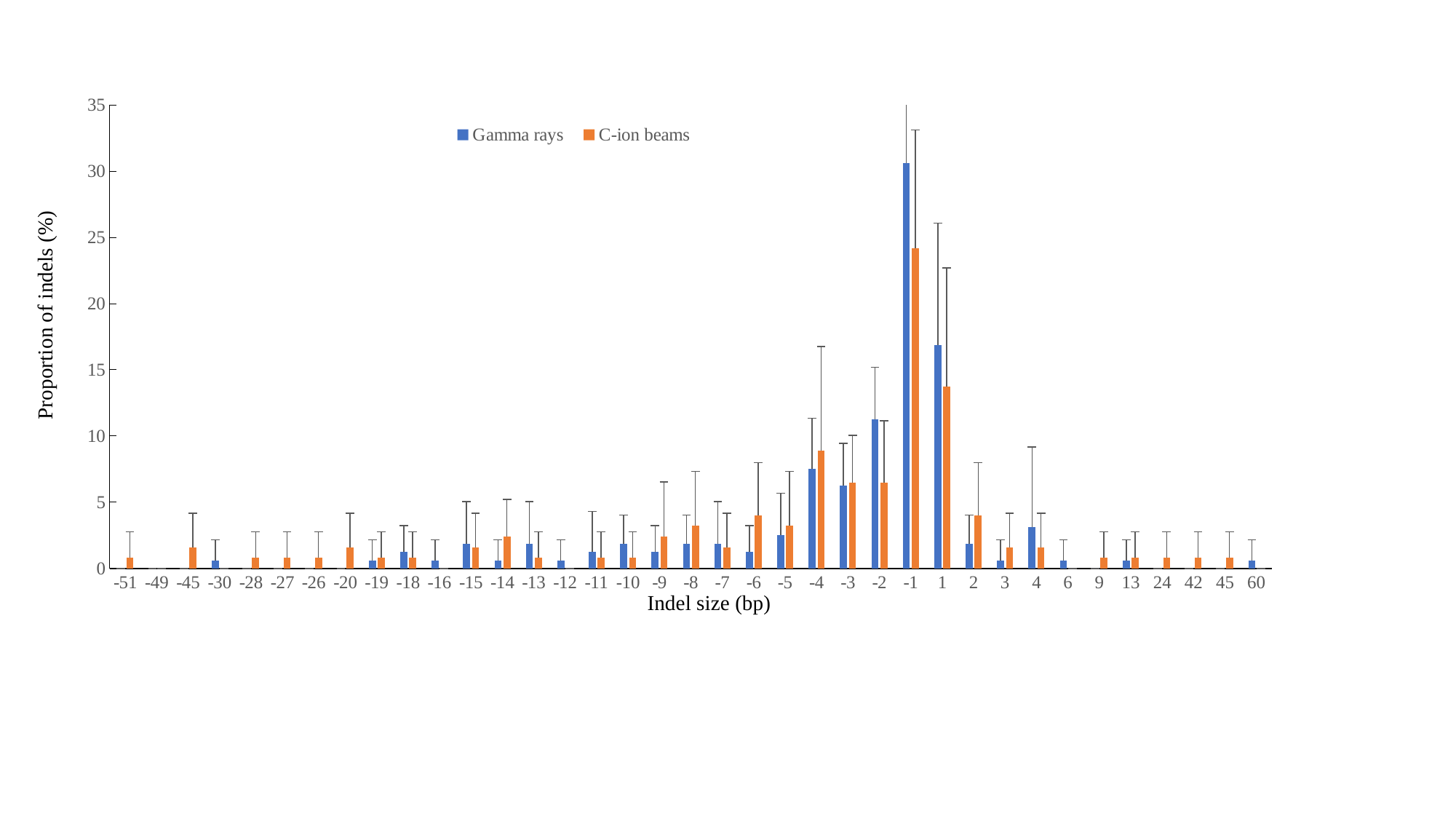
For indel size 1, which series has the larger value, Gamma rays or C-ion beams? Gamma rays Is the C-ion beams value for indel size -1 greater or less than 25? less How many indel size categories are shown on the x axis? 37 Is the Gamma rays value for indel size -1 greater or less than 30? greater Is the Gamma rays value for indel size -2 greater or less than 10? greater How many series does the legend list? 2 At which indel size is the C-ion beams value highest? -1 At which indel size is the Gamma rays value highest? -1 What are the two series named in the legend? Gamma rays and C-ion beams What kind of chart is shown on the slide? bar chart For indel size -4, which series has the larger value, Gamma rays or C-ion beams? C-ion beams